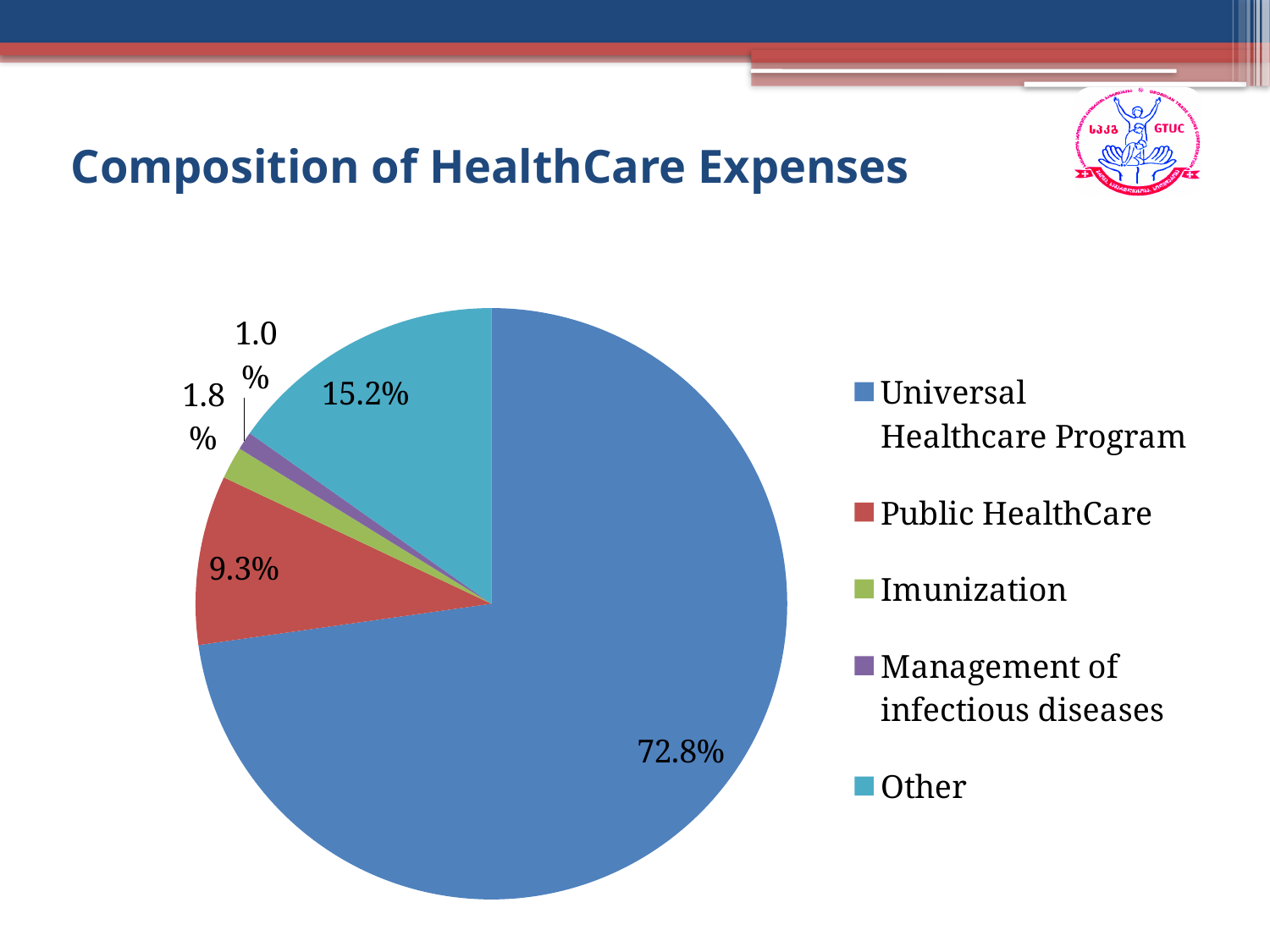
What percentage of the pie is Public HealthCare? 9.3% Which category has the largest share of healthcare expenses? Universal Healthcare Program What share of healthcare expenses goes to the Universal Healthcare Program? 72.8% Which category has the smallest share of healthcare expenses? Management of infectious diseases Which is larger, the share for Public HealthCare or the share for Other? Other How many categories does the pie chart show? 5 What percentage is shown for Imunization? 1.8% What type of chart is shown on the slide? Pie chart What is the value shown for the Other slice? 15.2% What percentage is shown for Management of infectious diseases? 1.0% How many percentage points larger is the Other slice than the Public HealthCare slice? 5.9 What is the title of the chart on the slide? Composition of HealthCare Expenses